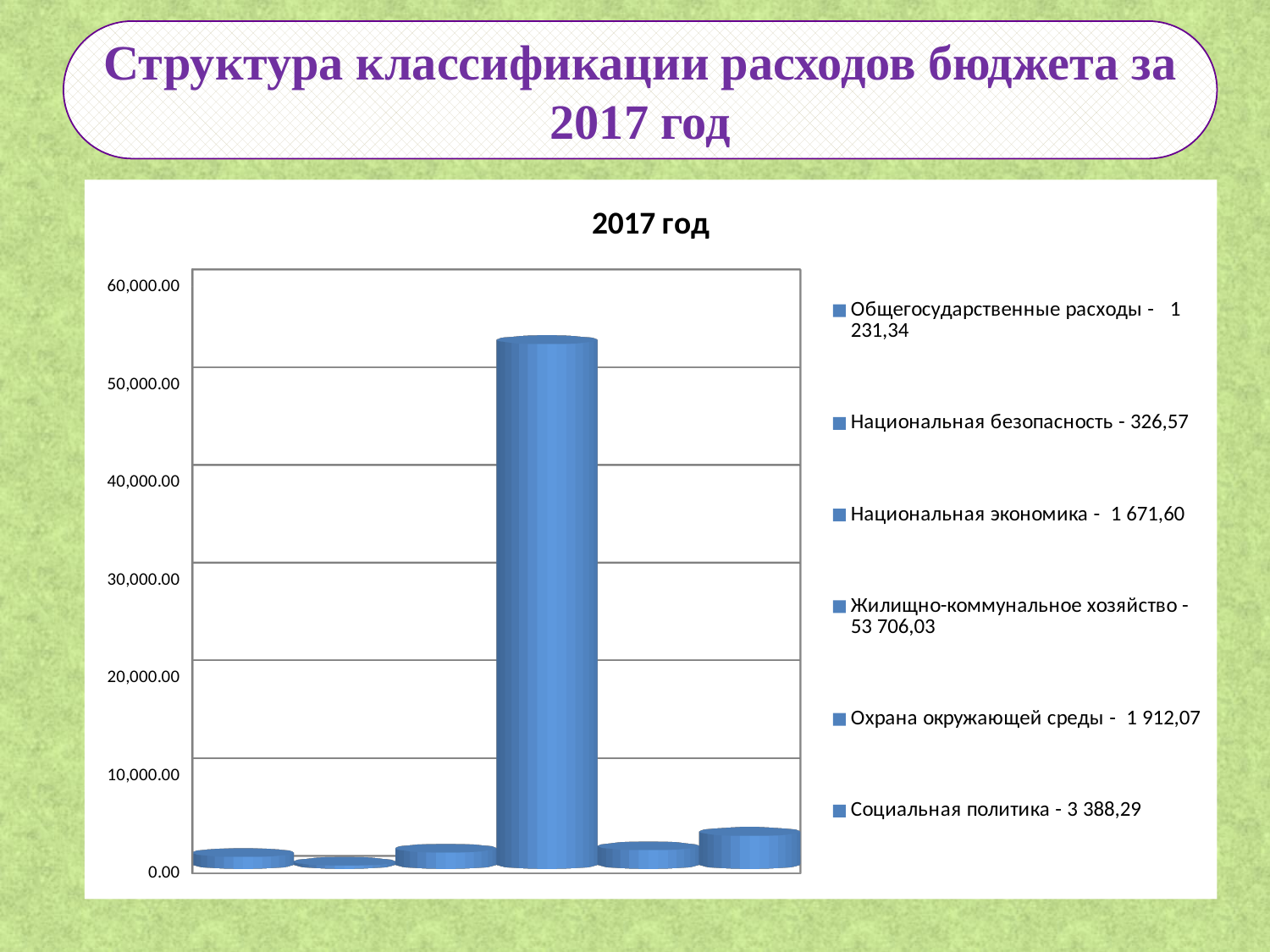
Is the value for Жилищно-коммунальное хозяйство greater or less than 50,000.00? greater Which is larger, the value for Охрана окружающей среды or the value for Национальная экономика? Охрана окружающей среды What is the title of the chart? 2017 год How many bars are plotted in the chart? 6 What kind of chart is shown on the slide? bar chart What is the difference between the values for Жилищно-коммунальное хозяйство and Социальная политика? 50 317,74 What value does the legend give for Социальная политика? 3 388,29 What value does the legend give for Жилищно-коммунальное хозяйство? 53 706,03 Which category has the highest value? Жилищно-коммунальное хозяйство Which category has the lowest value? Национальная безопасность What value does the legend give for Национальная безопасность? 326,57 What is the difference between the values for Общегосударственные расходы and Национальная безопасность? 904,77